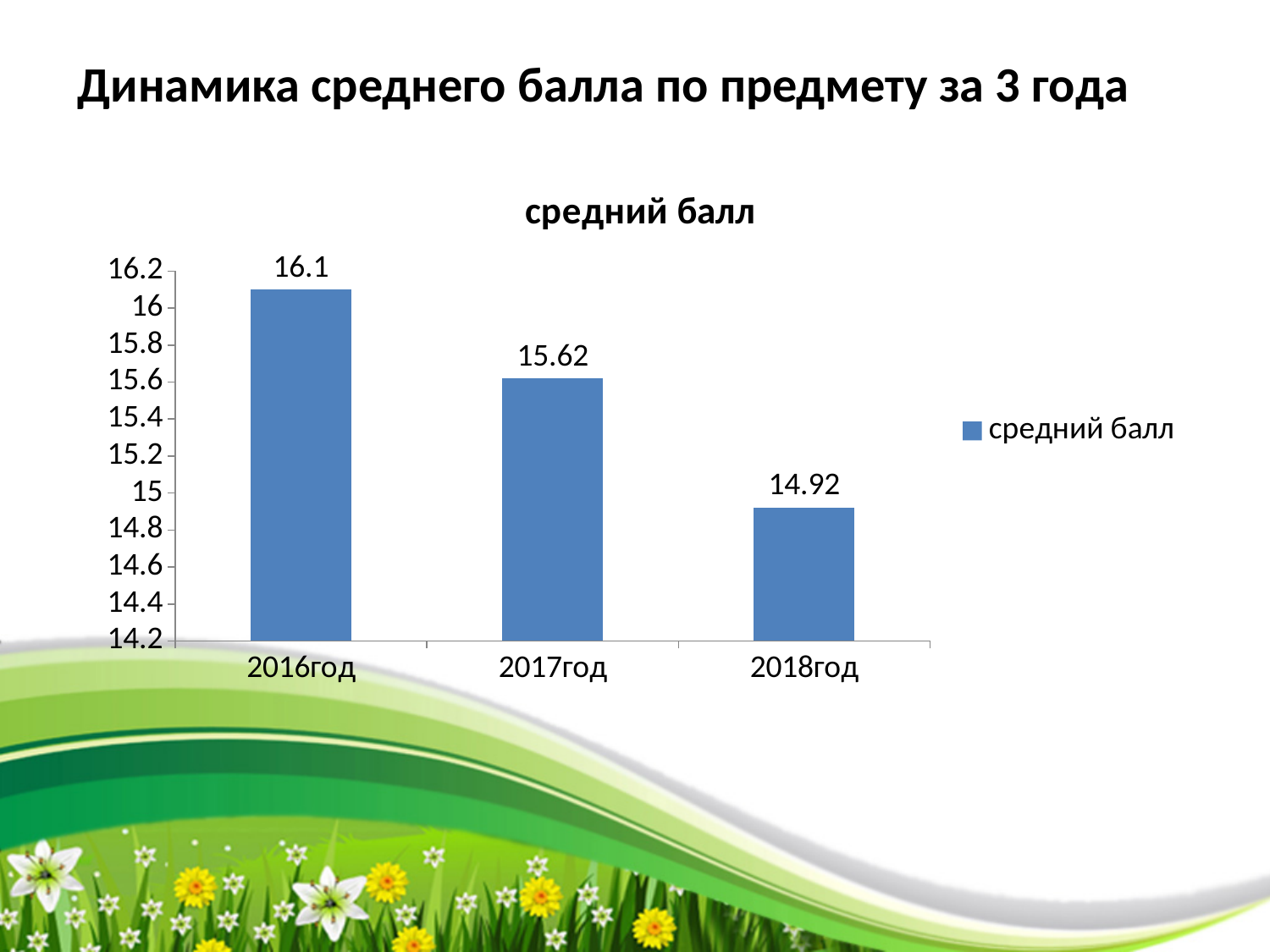
Which year has the lowest average score? 2018год Which year has the highest average score? 2016год What kind of chart is shown on the slide? bar chart Which is larger, the average score for 2017год or for 2018год? 2017год What is the average score (средний балл) for 2018год? 14.92 What is the difference between the average score in 2017год and 2018год? 0.7 Do the average scores rise or fall from 2016год to 2018год? fall How many years are shown on the x axis? 3 Is the value for 2018год greater or less than 15? less What is the difference between the average score in 2016год and 2018год? 1.18 What is the average score (средний балл) for 2016год? 16.1 What is the average score (средний балл) for 2017год? 15.62